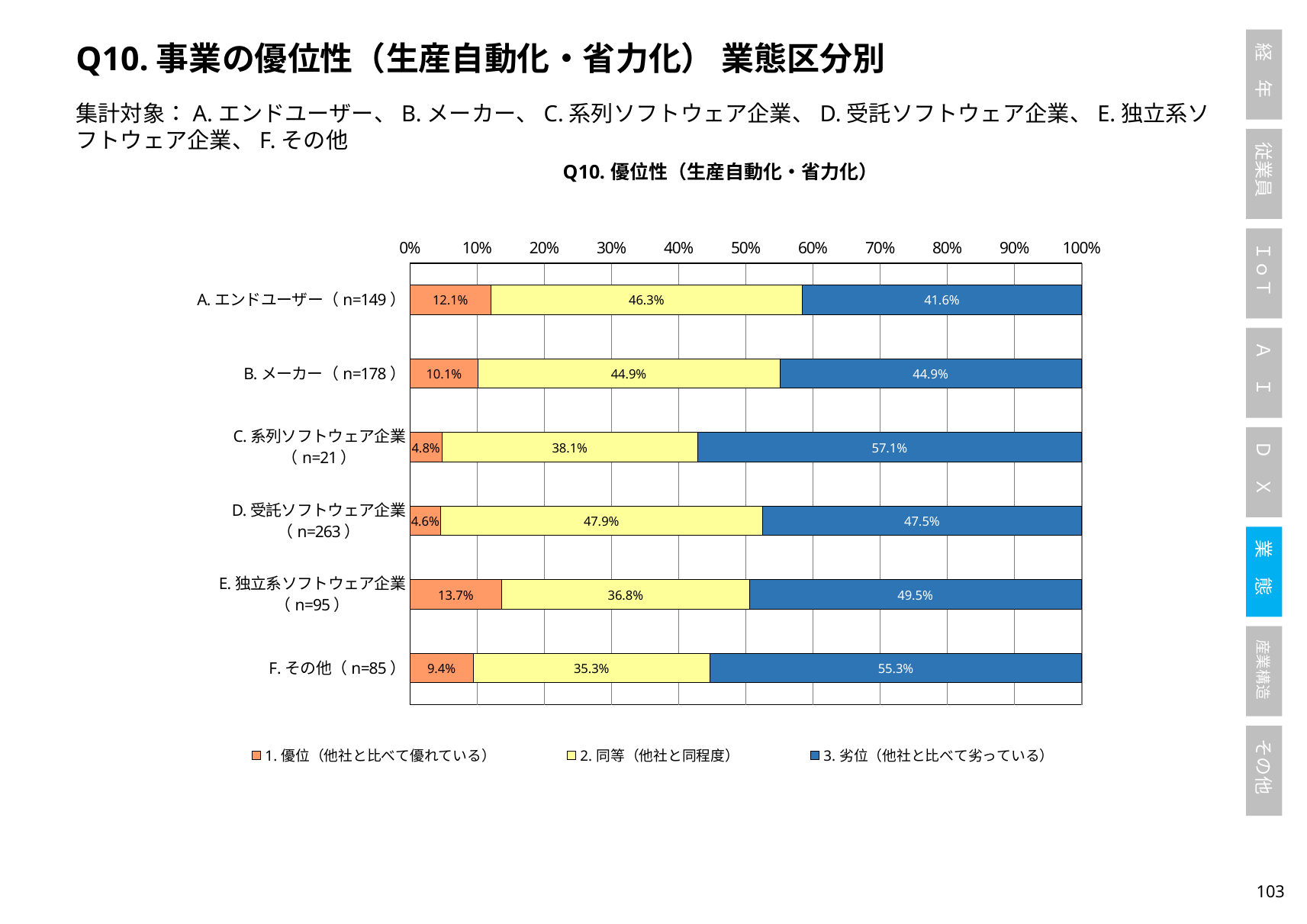
What is the difference between the 「3. 劣位」 values for C. 系列ソフトウェア企業 and A. エンドユーザー? 15.5% What type of chart is shown on the slide? Stacked bar chart What is the value of 「3. 劣位」 for C. 系列ソフトウェア企業 (n=21)? 57.1% What is the value of 「1. 優位」 for A. エンドユーザー (n=149)? 12.1% Which category has the highest value for 「1. 優位」? E. 独立系ソフトウェア企業 (n=95) Which category has the lowest value for 「1. 優位」? D. 受託ソフトウェア企業 (n=263) What is the value of 「2. 同等」 for D. 受託ソフトウェア企業 (n=263)? 47.9% What is the title of the chart? Q10. 優位性（生産自動化・省力化） How many categories (業態区分) are plotted on the chart? 6 How many series does the legend list? 3 Which category has the lowest value for 「2. 同等」? F. その他 (n=85) Which is larger: the 「3. 劣位」 value for F. その他 or for E. 独立系ソフトウェア企業? F. その他